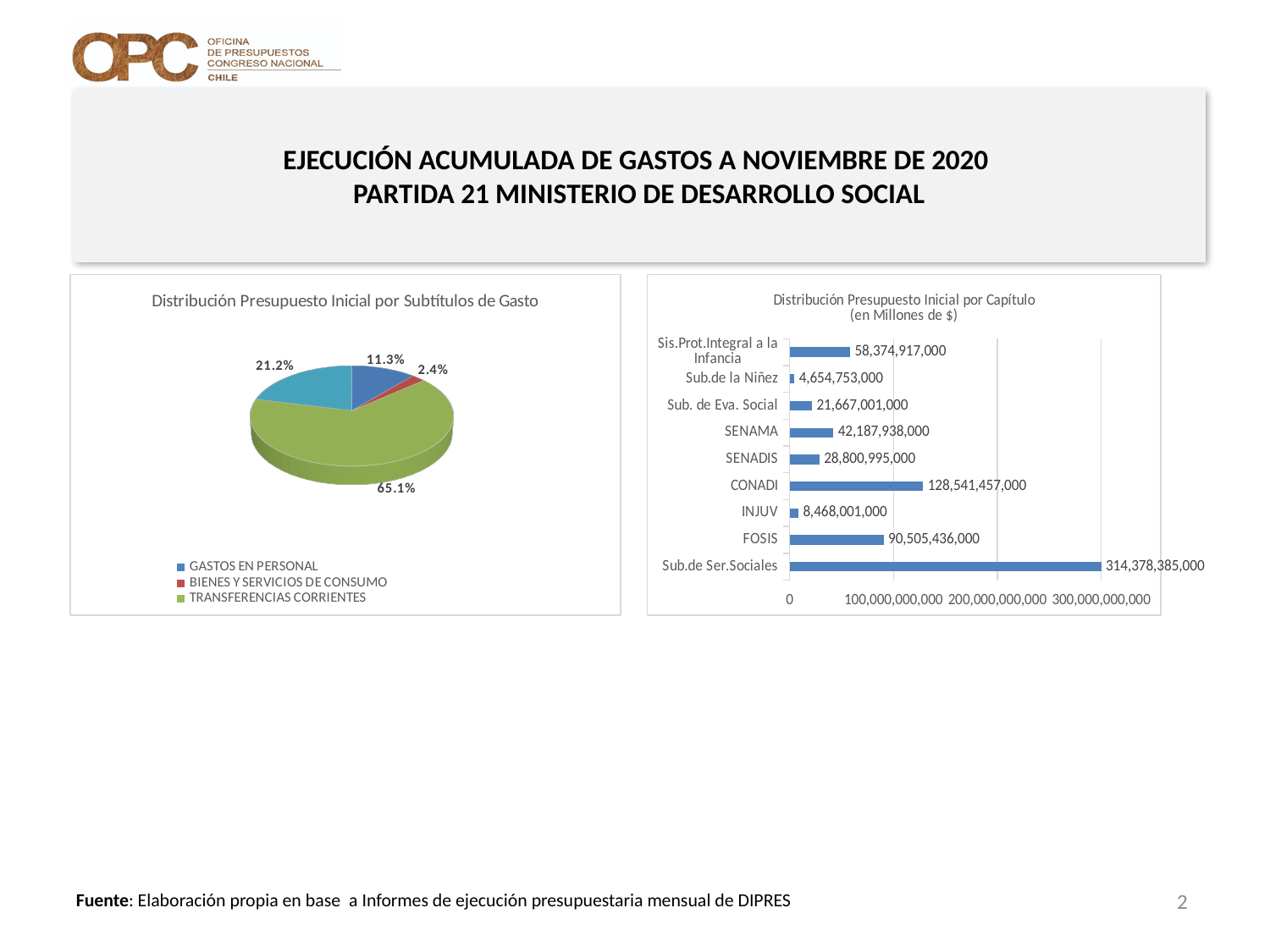
In the bar chart 'Distribución Presupuesto Inicial por Capítulo', which category has the lowest value? Sub.de la Niñez In the bar chart 'Distribución Presupuesto Inicial por Capítulo', which category has the highest value? Sub.de Ser.Sociales In the pie chart 'Distribución Presupuesto Inicial por Subtítulos de Gasto', which legend entry has the largest slice? TRANSFERENCIAS CORRIENTES In the bar chart 'Distribución Presupuesto Inicial por Capítulo', what is the difference between the values for SENAMA and SENADIS? 13,386,943,000 In the pie chart 'Distribución Presupuesto Inicial por Subtítulos de Gasto', what share does BIENES Y SERVICIOS DE CONSUMO have? 2.4% In the bar chart 'Distribución Presupuesto Inicial por Capítulo', what is the value for CONADI? 128,541,457,000 In the bar chart 'Distribución Presupuesto Inicial por Capítulo', how many categories are shown? 9 In the bar chart 'Distribución Presupuesto Inicial por Capítulo', what is the value for FOSIS? 90,505,436,000 In the pie chart 'Distribución Presupuesto Inicial por Subtítulos de Gasto', how many entries does the legend list? 3 In the pie chart 'Distribución Presupuesto Inicial por Subtítulos de Gasto', what share does TRANSFERENCIAS CORRIENTES have? 65.1% What kind of chart is 'Distribución Presupuesto Inicial por Capítulo (en Millones de $)'? Bar chart In the pie chart 'Distribución Presupuesto Inicial por Subtítulos de Gasto', what share does GASTOS EN PERSONAL have? 11.3%